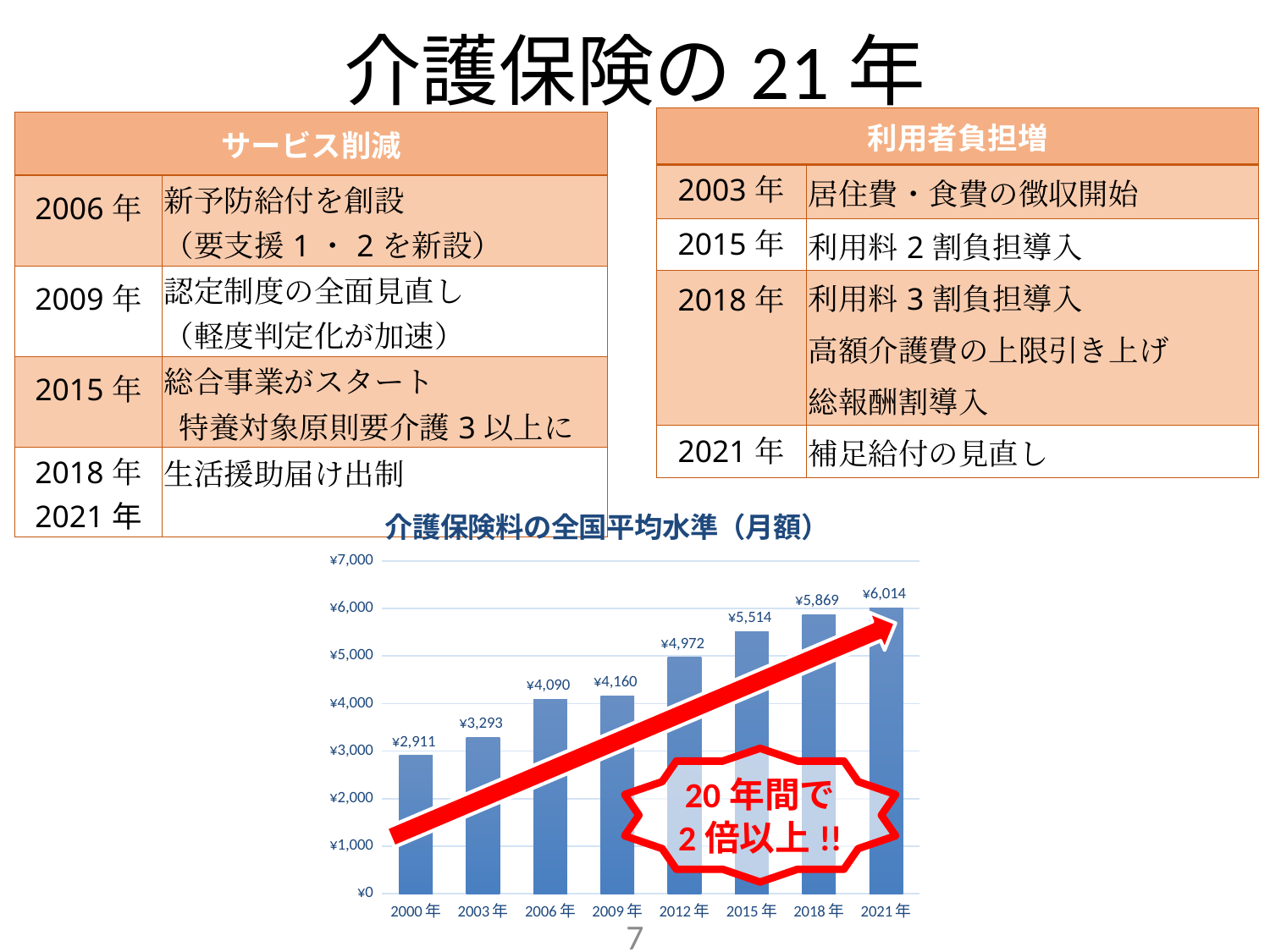
Which year has the lowest value in the chart 介護保険料の全国平均水準（月額）? 2000年 Which is larger in the chart 介護保険料の全国平均水準（月額）: the value for 2006年 or the value for 2012年? 2012年 What kind of chart is 介護保険料の全国平均水準（月額）? bar chart Is the value for 2015年 in the chart 介護保険料の全国平均水準（月額） greater or less than ¥5,000? greater What is the value for 2018年 in the chart 介護保険料の全国平均水準（月額）? ¥5,869 Do the values in the chart 介護保険料の全国平均水準（月額） rise or fall from 2000年 to 2021年? rise What is the difference between the values for 2021年 and 2000年 in the chart 介護保険料の全国平均水準（月額）? ¥3,103 What is the value for 2000年 in the chart 介護保険料の全国平均水準（月額）? ¥2,911 Which year has the highest value in the chart 介護保険料の全国平均水準（月額）? 2021年 How many years are shown on the x axis of the chart 介護保険料の全国平均水準（月額）? 8 What is the value for 2012年 in the chart 介護保険料の全国平均水準（月額）? ¥4,972 What is the difference between the values for 2015年 and 2012年 in the chart 介護保険料の全国平均水準（月額）? ¥542